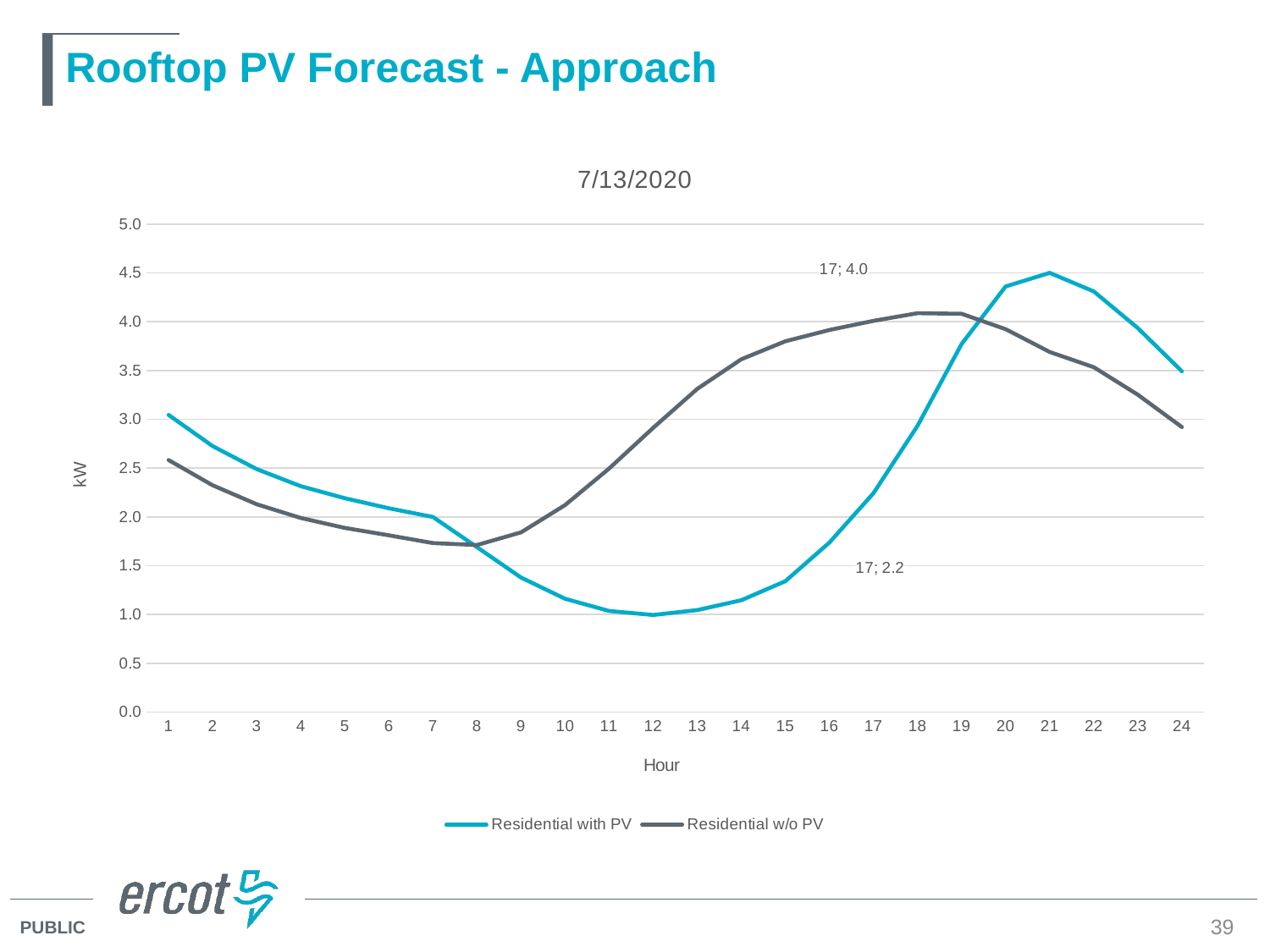
Does the Residential with PV line rise or fall from hour 1 to hour 7? fall Is the value for Residential w/o PV at hour 1 greater or less than 3.0? less How many hours are plotted along the x axis? 24 Is the value for Residential with PV at hour 12 greater or less than 1.5? less What is the title of the chart? 7/13/2020 What is the value for Residential w/o PV at hour 17? 4.0 At hour 17, which series has the larger value, Residential with PV or Residential w/o PV? Residential w/o PV What is the value for Residential with PV at hour 17? 2.2 Is the value for Residential with PV at hour 21 greater or less than 4.0? greater What kind of chart is shown on the slide? line chart How many series does the legend list? 2 What is the difference between Residential w/o PV and Residential with PV at hour 17? 1.8